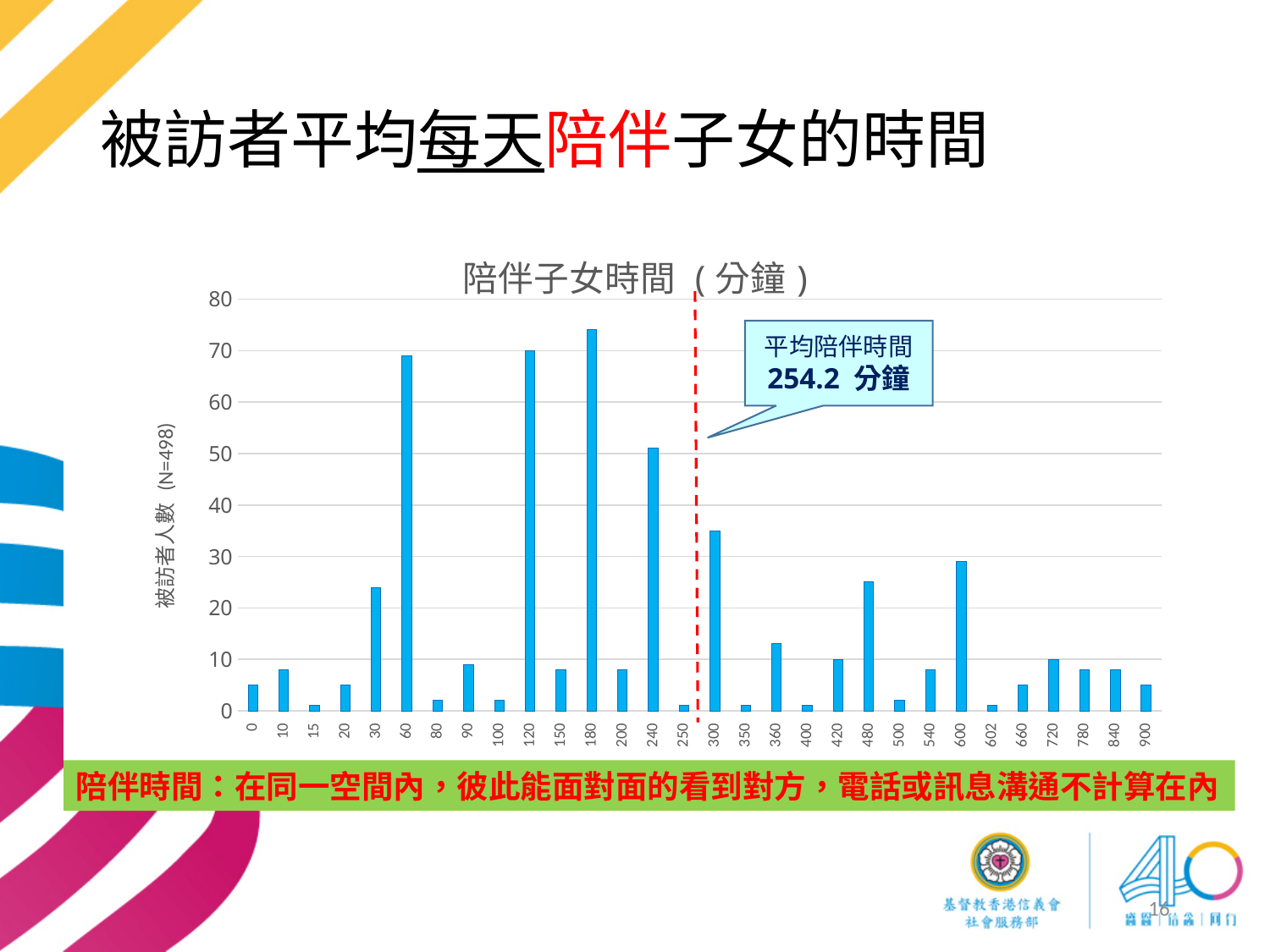
How many categories are shown on the x axis of the chart? 30 Is the value for 240 greater or less than 40? greater Is the value for 480 greater or less than 20? greater What average companionship time is stated in the callout on the chart? 254.2 分鐘 Which has a larger value, 60 or 240? 60 Which x-axis category has the highest bar? 180 Which has a larger value, 300 or 600? 300 Is the value for 60 greater or less than 60? greater What kind of chart is shown on the slide? bar chart What is the title of the chart? 陪伴子女時間（分鐘）